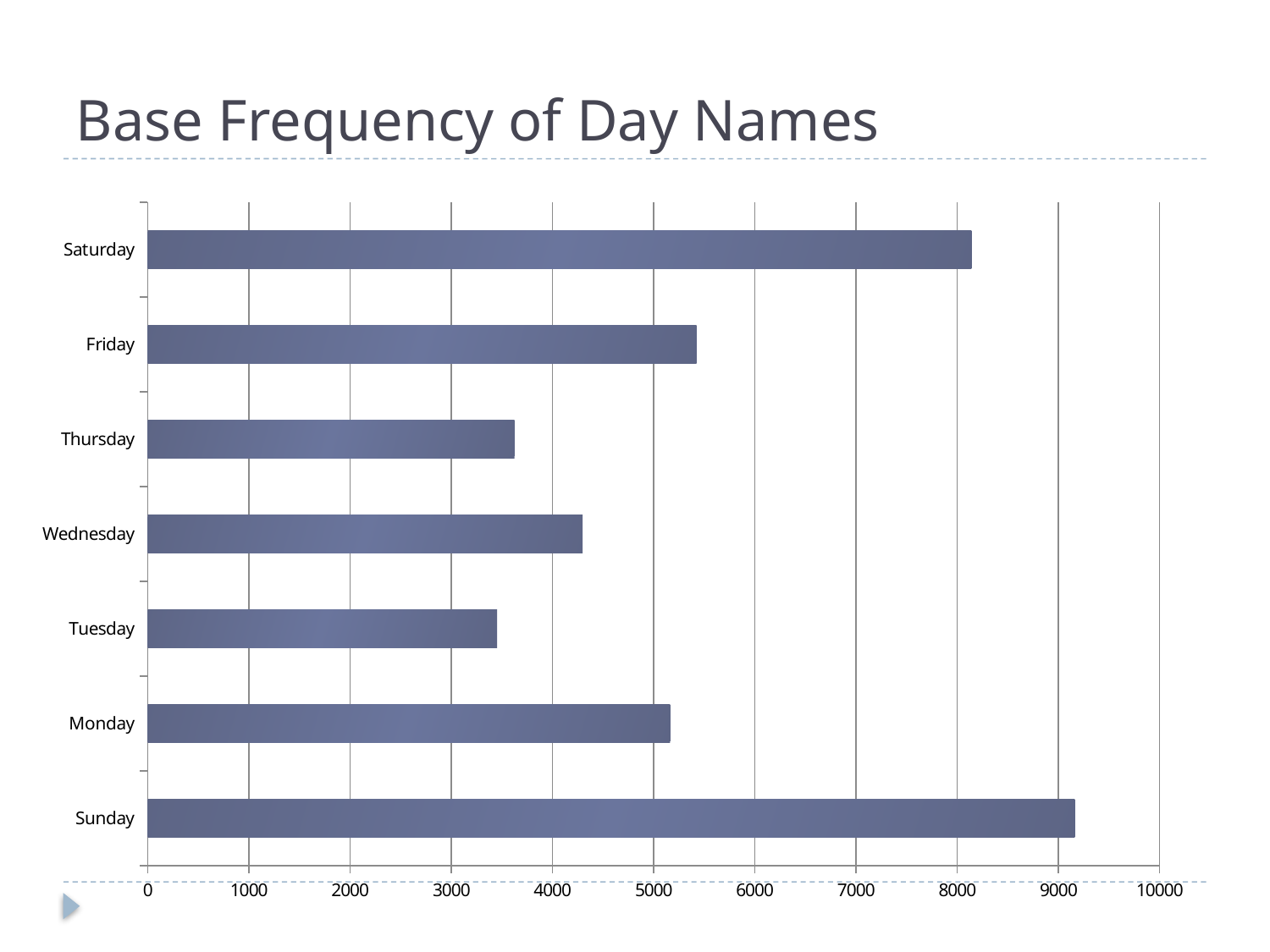
What kind of chart is shown on the slide? bar chart Is the value for Sunday greater or less than 8000? greater Is the value for Thursday greater or less than 4000? less Is the value for Tuesday greater or less than 4000? less Which day has the highest base frequency? Sunday Which is larger, the value for Wednesday or the value for Thursday? Wednesday How many day categories are plotted in the chart? 7 Which is larger, the value for Saturday or the value for Friday? Saturday What is the title of the chart? Base Frequency of Day Names